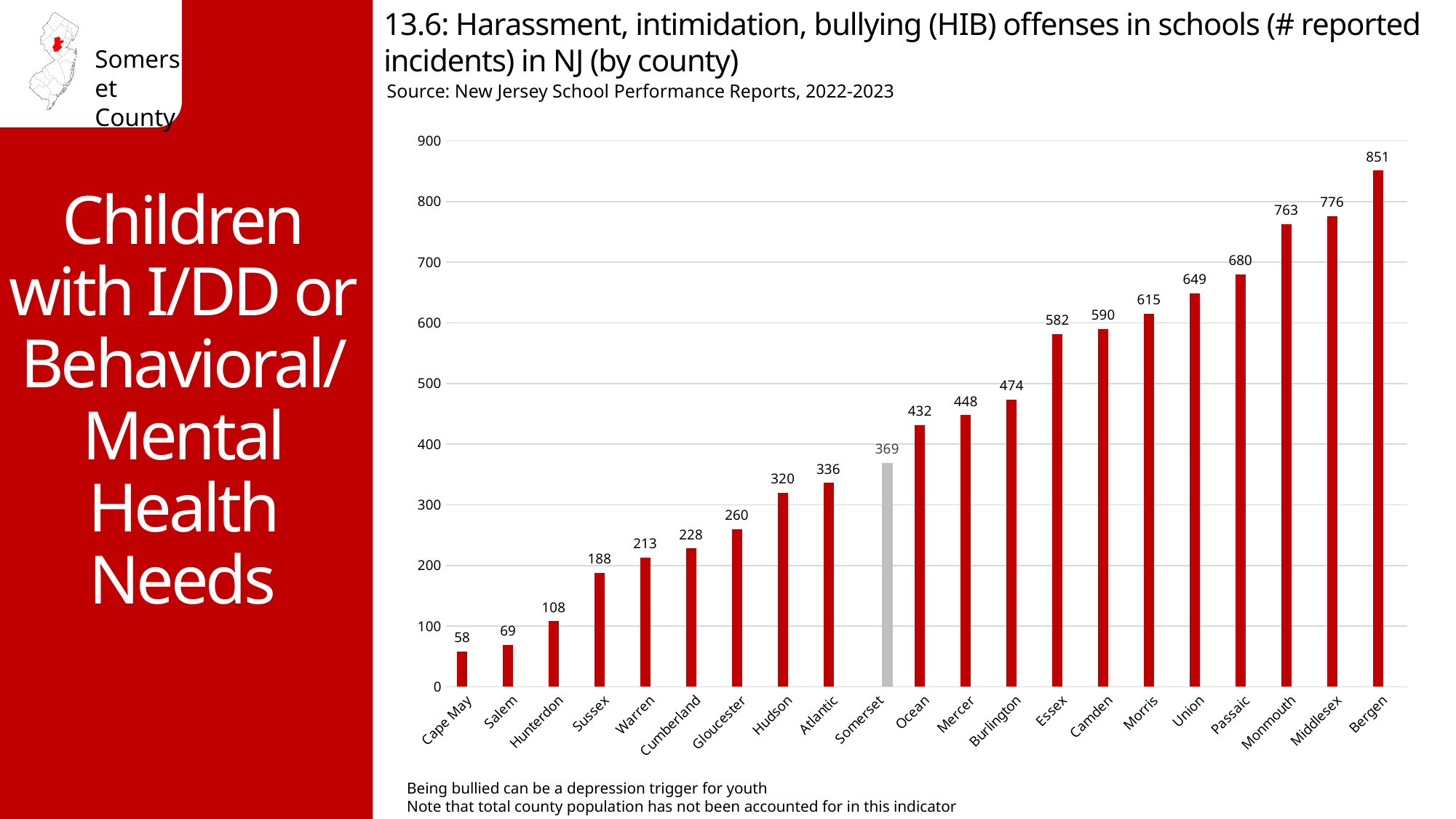
Which county has the highest number of reported HIB incidents? Bergen What type of chart is used on this slide? Bar chart Do the values rise or fall moving from left to right along the x axis? Rise What is the number of reported HIB incidents for Hudson County? 320 What is the number of reported HIB incidents for Bergen County? 851 What is the number of reported HIB incidents for Somerset County? 369 Which county has the lowest number of reported HIB incidents? Cape May Which county's bar is shown in grey rather than red? Somerset How many counties are shown on the chart? 21 Which county has more reported HIB incidents, Essex or Camden? Camden What is the difference in reported HIB incidents between Bergen and Somerset? 482 What is the difference in reported HIB incidents between Middlesex and Monmouth? 13